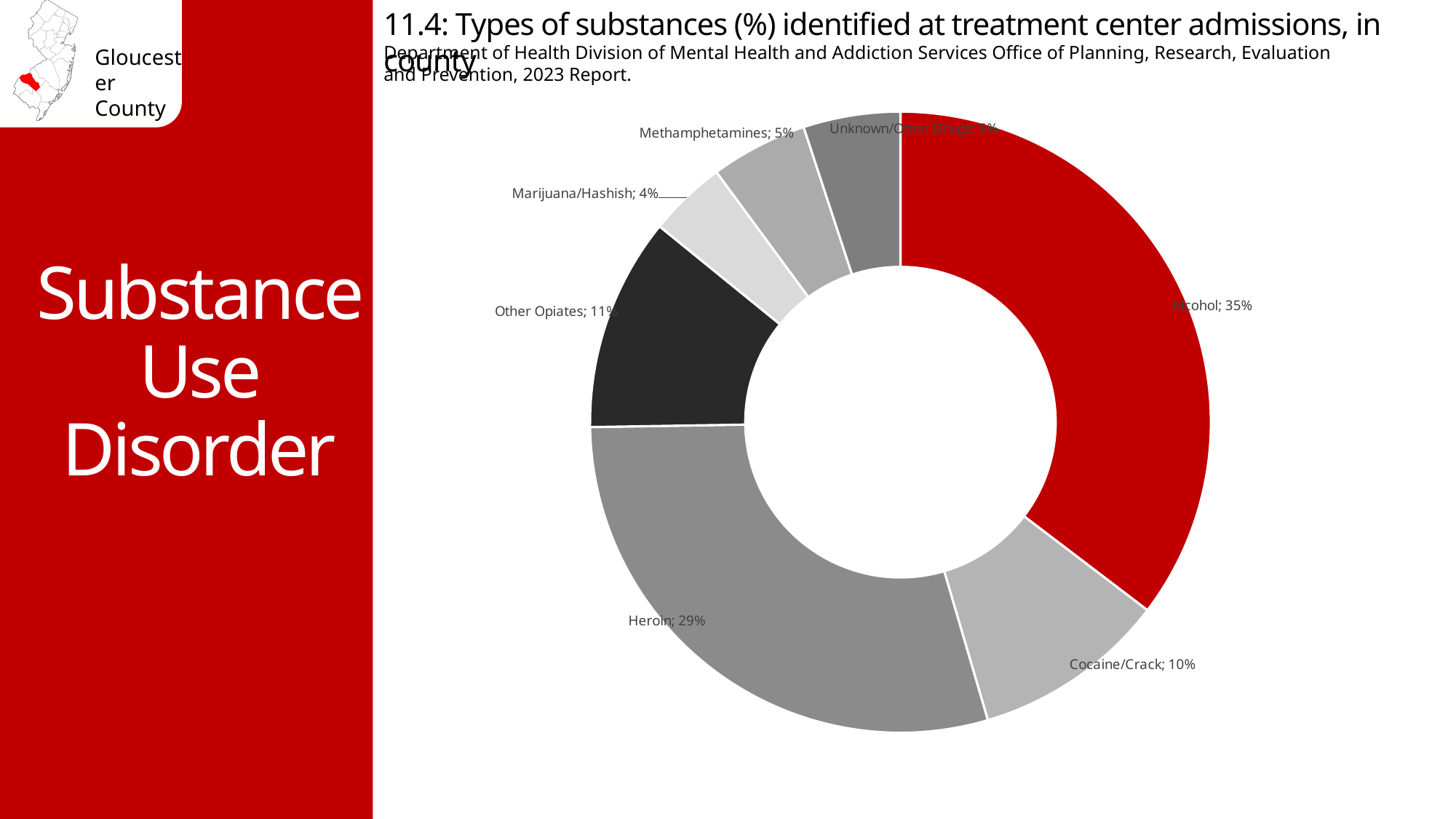
What percentage is shown for Marijuana/Hashish? 4% What percentage is shown for Other Opiates? 11% What kind of chart is used on this slide? doughnut chart Which substance has the largest share of admissions? Alcohol Which labeled substance has the smallest share of admissions? Marijuana/Hashish How many substance categories are shown in the chart? 7 What percentage is shown for Heroin? 29% What percentage of treatment center admissions is identified as Alcohol? 35% What percentage is shown for Methamphetamines? 5% What is the difference in percentage points between Alcohol and Heroin? 6 Which has a larger share, Other Opiates or Cocaine/Crack? Other Opiates What percentage is shown for Cocaine/Crack? 10%